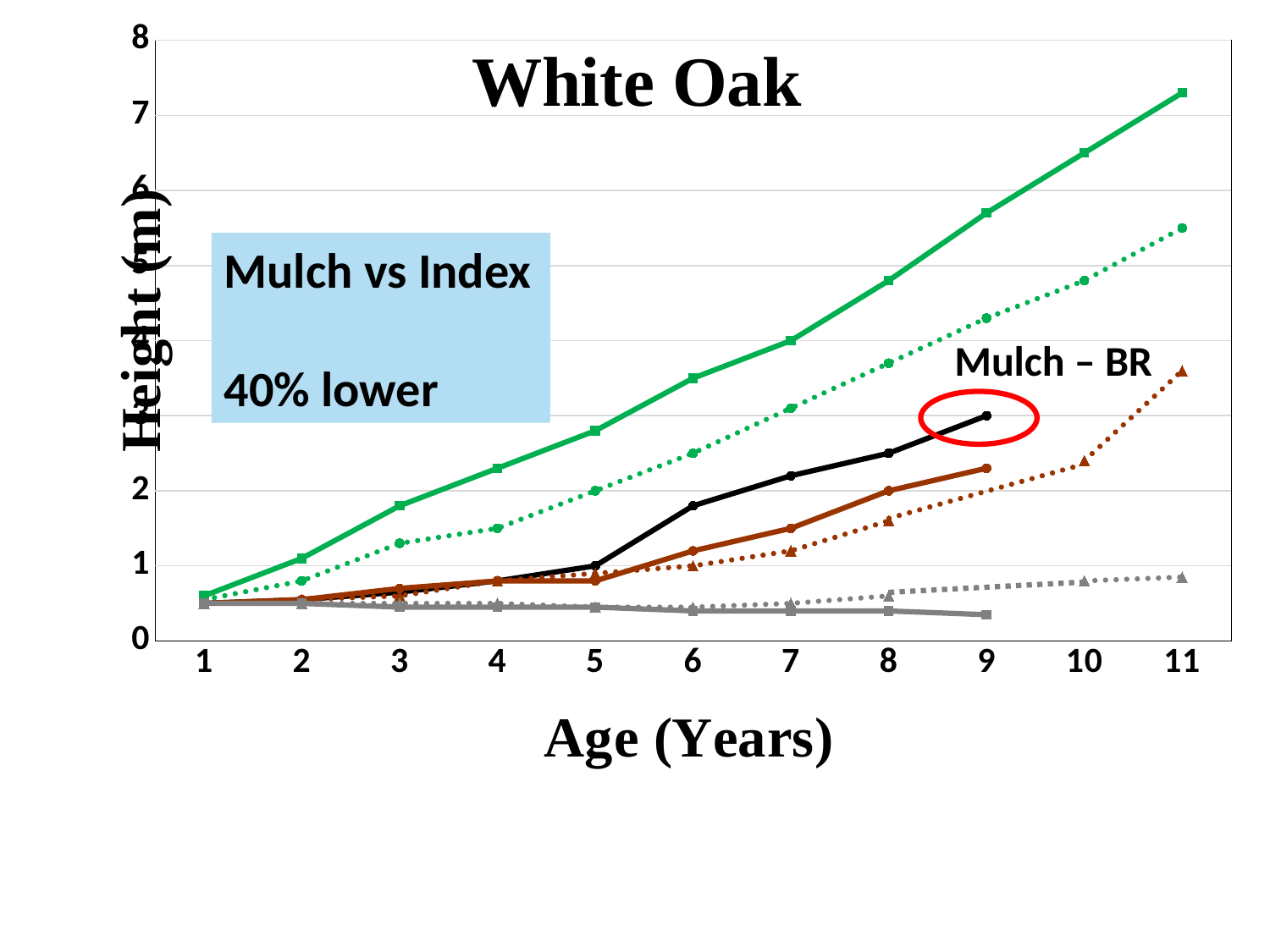
Is the height for Mulch – BR at age 8 greater or less than 3? less Does the Mulch – BR line rise or fall as age increases? rises Is the height for Mulch – BR at age 1 greater or less than 1? less How many age values are shown along the x axis? 11 How many data points does the Mulch – BR line have? 9 What is the label of the x axis? Age (Years) Is the height for Mulch – BR at age 6 greater or less than 1? greater What kind of chart is shown on the slide? line chart What is the title of the chart? White Oak